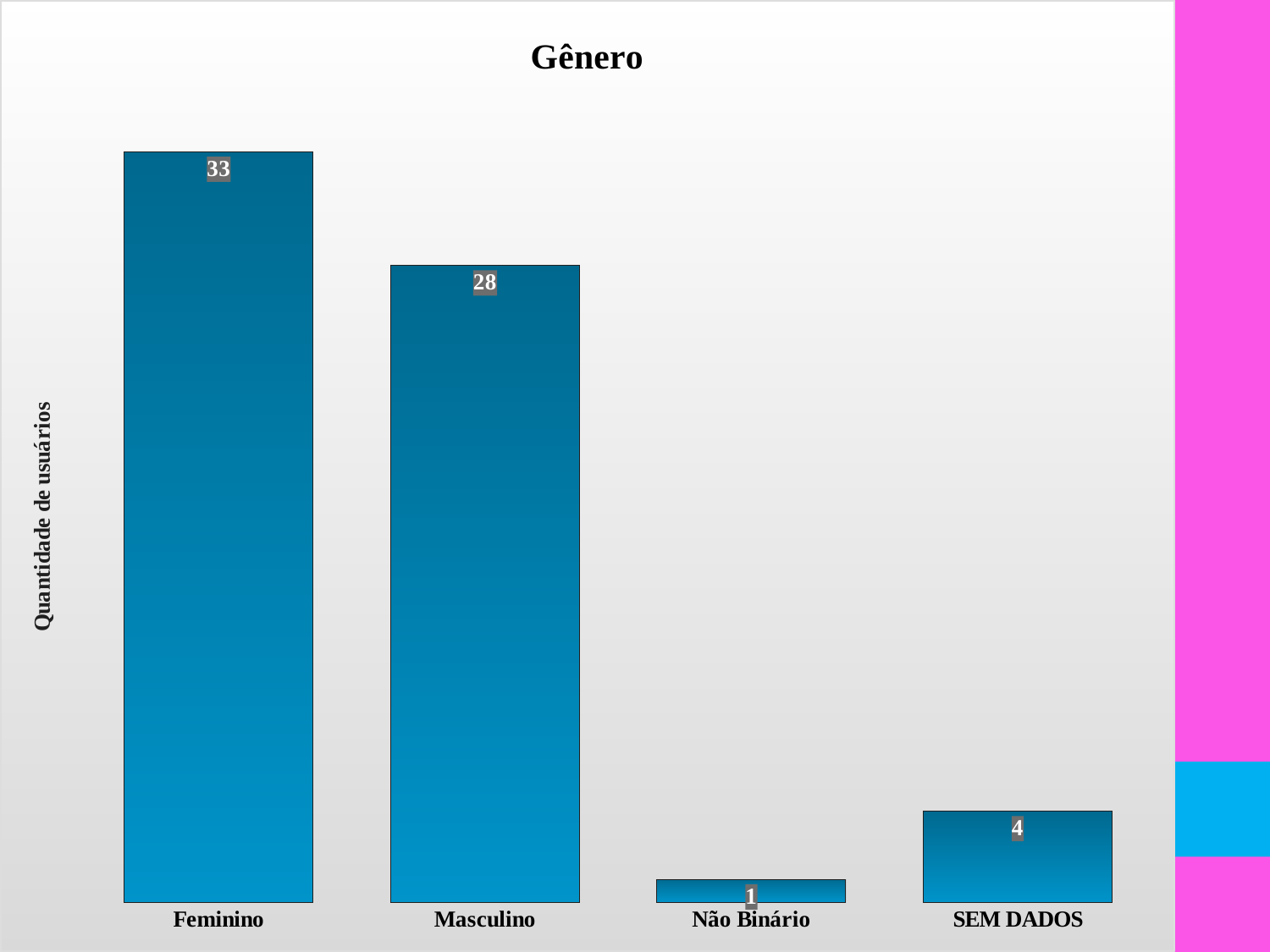
Which is larger, the value for Masculino or the value for SEM DADOS? Masculino What is the difference between the values for SEM DADOS and Não Binário? 3 What is the value for Feminino? 33 What is the value for SEM DADOS? 4 What is the difference between the values for Feminino and Masculino? 5 What kind of chart is this? Bar chart What is the value for Masculino? 28 How many categories are shown in the chart? 4 Which category has the lowest value? Não Binário What is the value for Não Binário? 1 What is the title of the chart? Gênero Which category has the highest value? Feminino